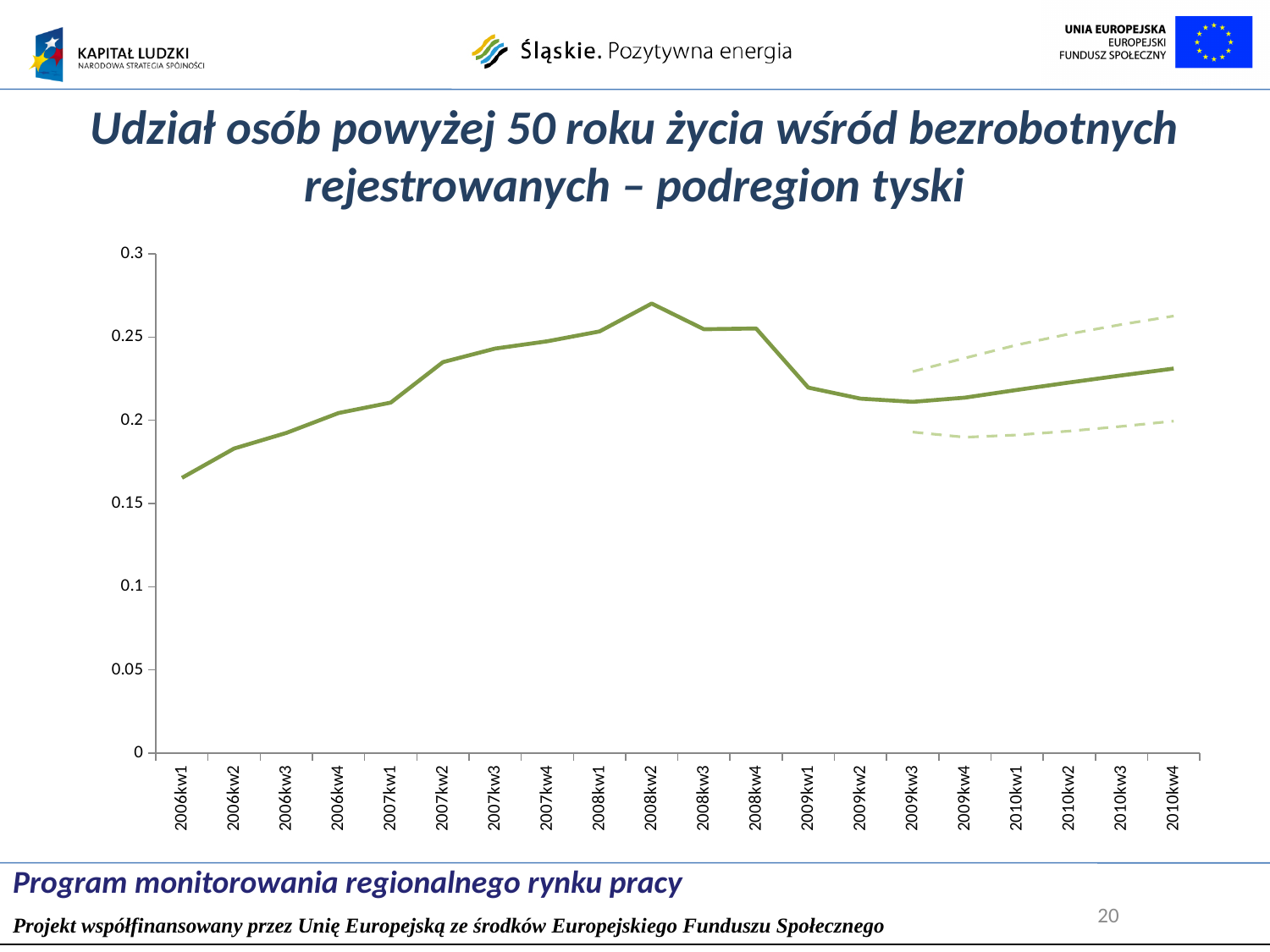
Is the value for 2009kw3 greater or less than 0.2? greater Which is larger, the value for 2006kw1 or the value for 2010kw4? 2010kw4 Is the value for 2006kw1 greater or less than 0.2? less In which quarter does the solid line reach its highest value? 2008kw2 Which is larger, the value for 2008kw2 or the value for 2009kw1? 2008kw2 How many quarters (categories) are shown on the x axis? 20 Do the values rise or fall from 2006kw1 to 2008kw2? rise Is the value for 2007kw2 greater or less than 0.25? less What is the title of the chart on the slide? Udział osób powyżej 50 roku życia wśród bezrobotnych rejestrowanych – podregion tyski In which quarter does the solid line have its lowest value? 2006kw1 What kind of chart is shown on the slide? line chart